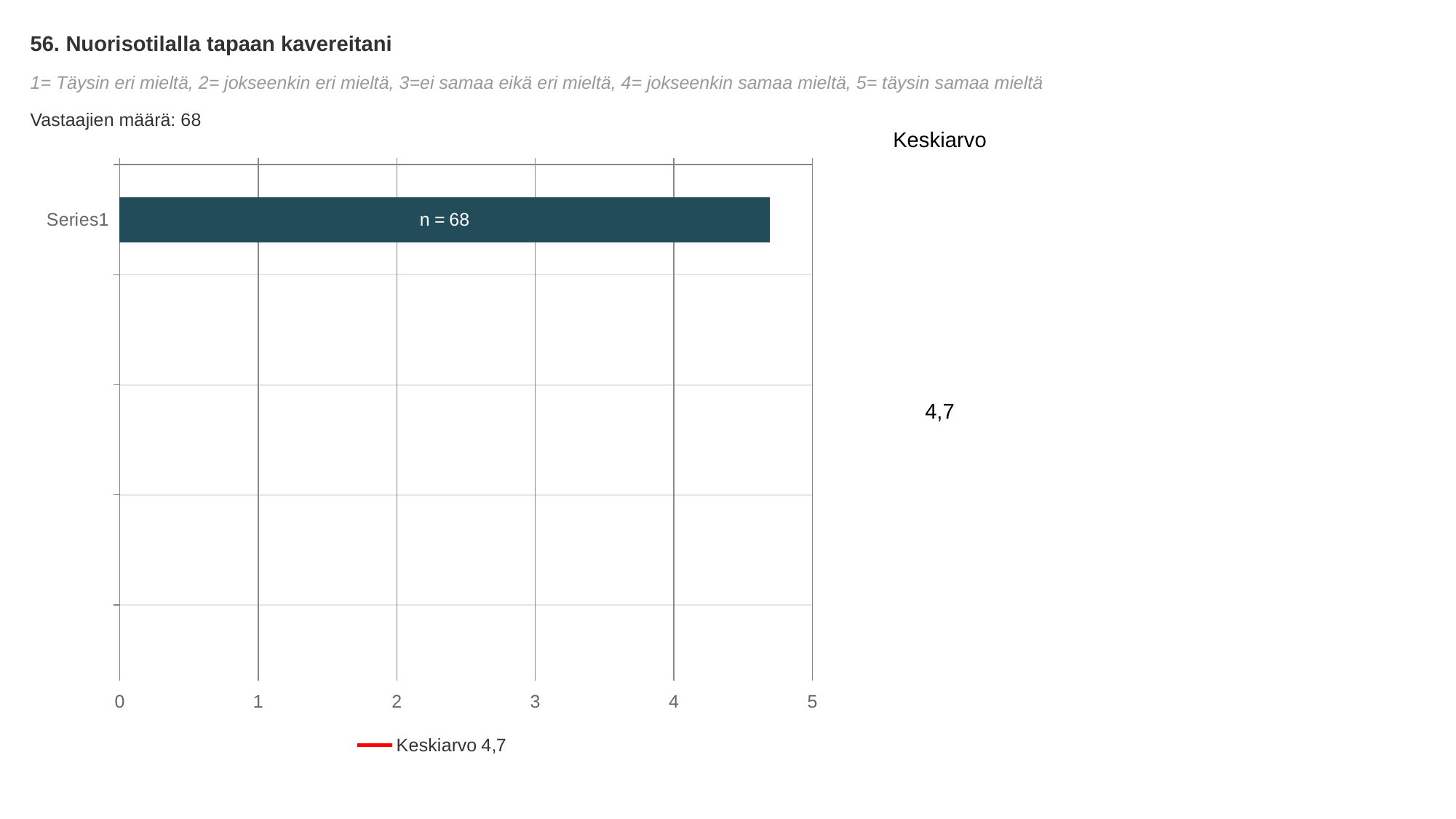
What is the Keskiarvo (mean) value shown on the slide? 4,7 What is the highest value shown on the horizontal axis? 5 What data label is printed on the Series1 bar? n = 68 What kind of chart is shown on the slide? bar chart Is the value of the Series1 bar greater or less than 5? less How many bars are plotted in the chart? 1 How many respondents (Vastaajien määrä) are reported on the slide? 68 What does the legend entry below the chart say? Keskiarvo 4,7 Is the value of the Series1 bar greater or less than 4? greater What is the label of the only category on the vertical axis? Series1